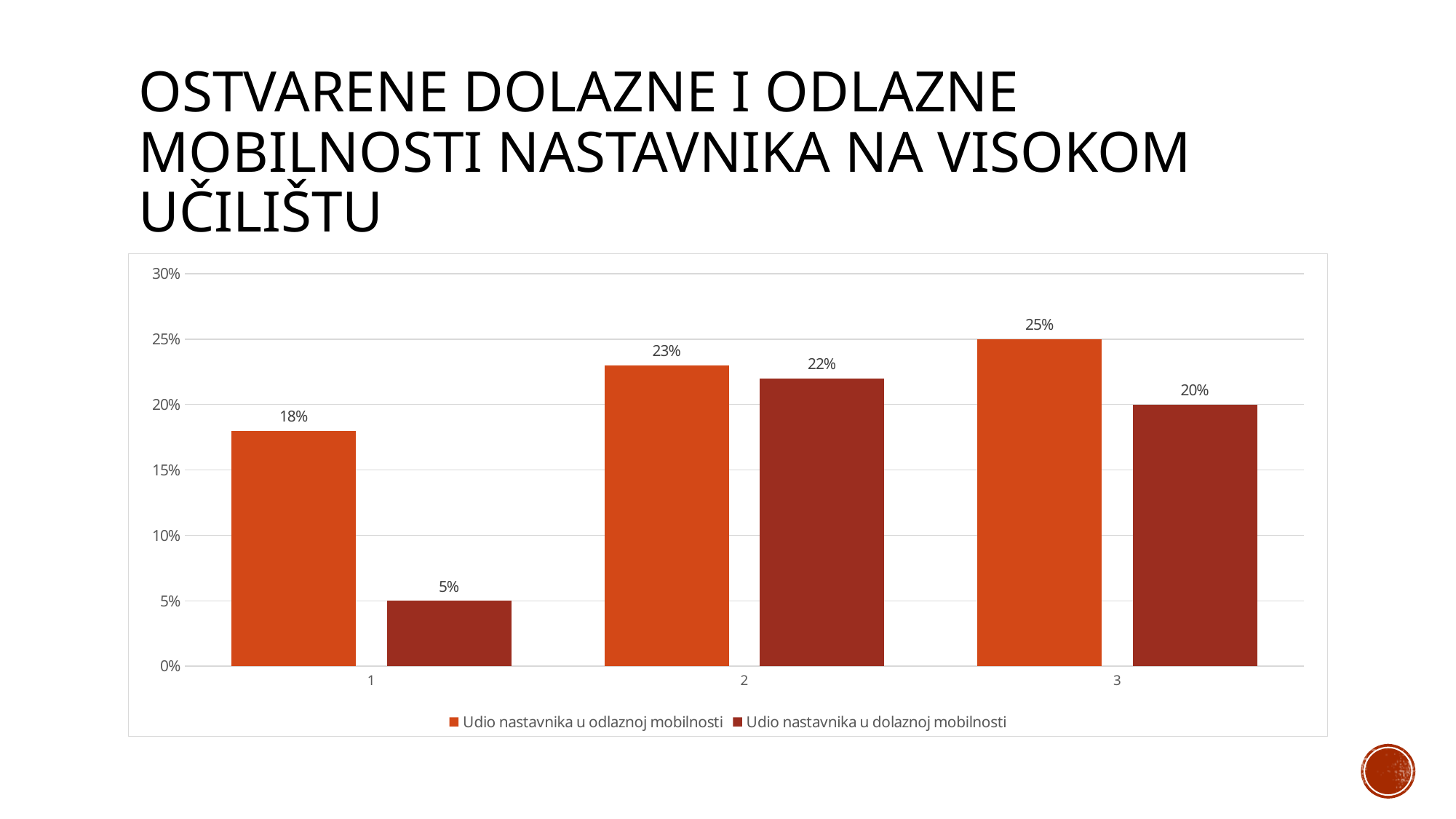
Which category has the lowest value for 'Udio nastavnika u dolaznoj mobilnosti'? 1 What is the value of 'Udio nastavnika u dolaznoj mobilnosti' for category 3? 20% For category 3, which series has the larger value: 'Udio nastavnika u odlaznoj mobilnosti' or 'Udio nastavnika u dolaznoj mobilnosti'? Udio nastavnika u odlaznoj mobilnosti What is the difference between 'Udio nastavnika u odlaznoj mobilnosti' and 'Udio nastavnika u dolaznoj mobilnosti' for category 1? 13% Does 'Udio nastavnika u odlaznoj mobilnosti' rise or fall from category 1 to category 3? Rise What is the difference between 'Udio nastavnika u odlaznoj mobilnosti' for category 3 and category 2? 2% Which category has the highest value for 'Udio nastavnika u odlaznoj mobilnosti'? 3 What is the value of 'Udio nastavnika u odlaznoj mobilnosti' for category 1? 18% What kind of chart is shown on the slide? Bar chart What is the value of 'Udio nastavnika u dolaznoj mobilnosti' for category 1? 5% How many categories are shown on the x axis? 3 How many series does the legend list? 2